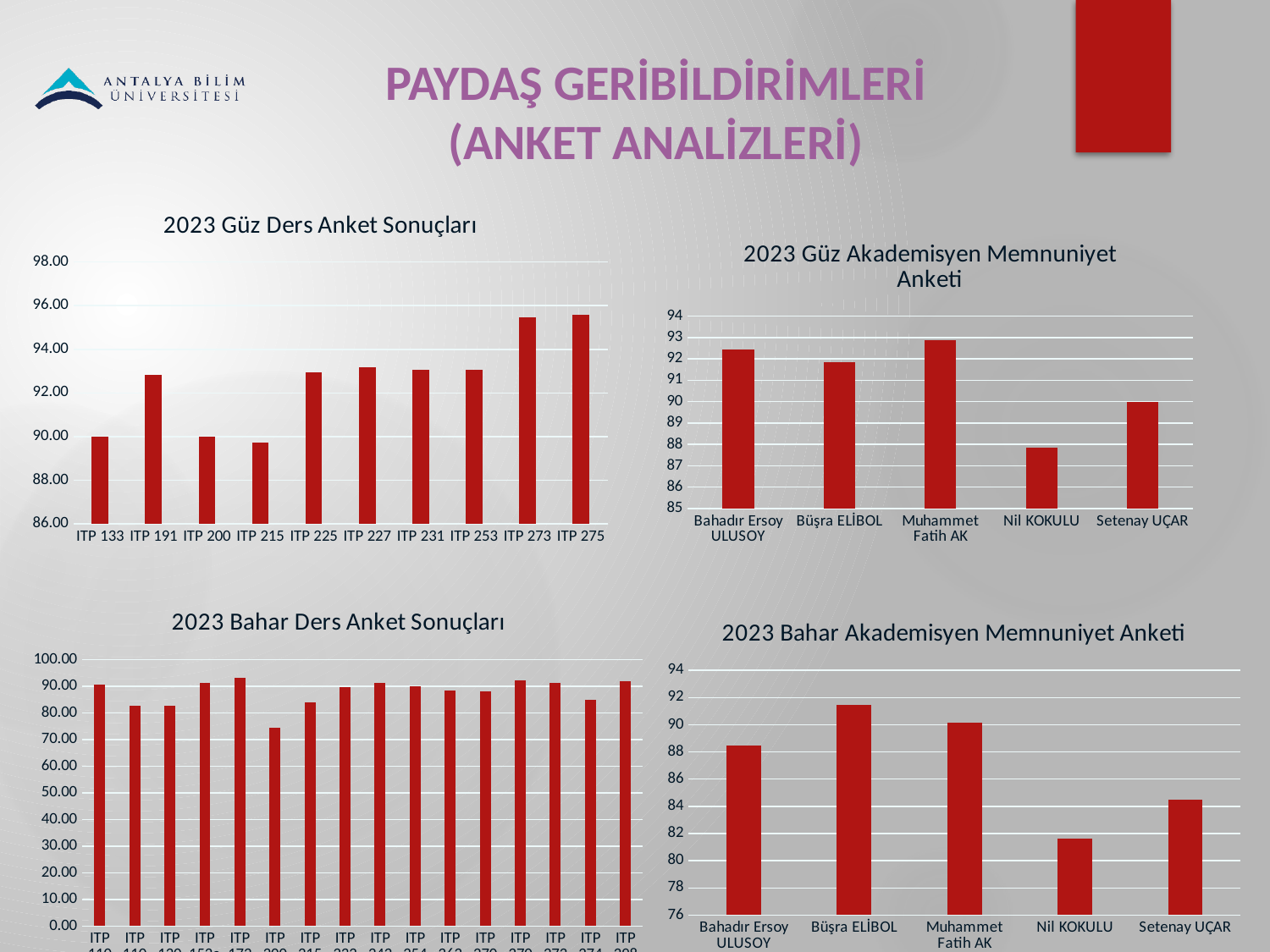
What kind of chart is "2023 Bahar Ders Anket Sonuçları"? Bar chart In the chart titled "2023 Güz Akademisyen Memnuniyet Anketi", which is larger, the value for Bahadır Ersoy ULUSOY or the value for Setenay UÇAR? Bahadır Ersoy ULUSOY In the chart titled "2023 Güz Ders Anket Sonuçları", is the value for ITP 191 greater or less than 92.00? greater In the chart titled "2023 Bahar Ders Anket Sonuçları", how many bars are plotted? 16 In the chart titled "2023 Güz Ders Anket Sonuçları", which is larger, the value for ITP 275 or the value for ITP 133? ITP 275 In the chart titled "2023 Güz Ders Anket Sonuçları", is the value for ITP 273 greater or less than 94.00? greater In the chart titled "2023 Güz Akademisyen Memnuniyet Anketi", is the value for Nil KOKULU greater or less than 89? less In the chart titled "2023 Bahar Akademisyen Memnuniyet Anketi", which academic has the lowest value? Nil KOKULU In the chart titled "2023 Bahar Akademisyen Memnuniyet Anketi", which academic has the highest value? Büşra ELİBOL In the chart titled "2023 Güz Ders Anket Sonuçları", how many courses are shown on the x axis? 10 In the chart titled "2023 Güz Akademisyen Memnuniyet Anketi", which academic has the lowest value? Nil KOKULU